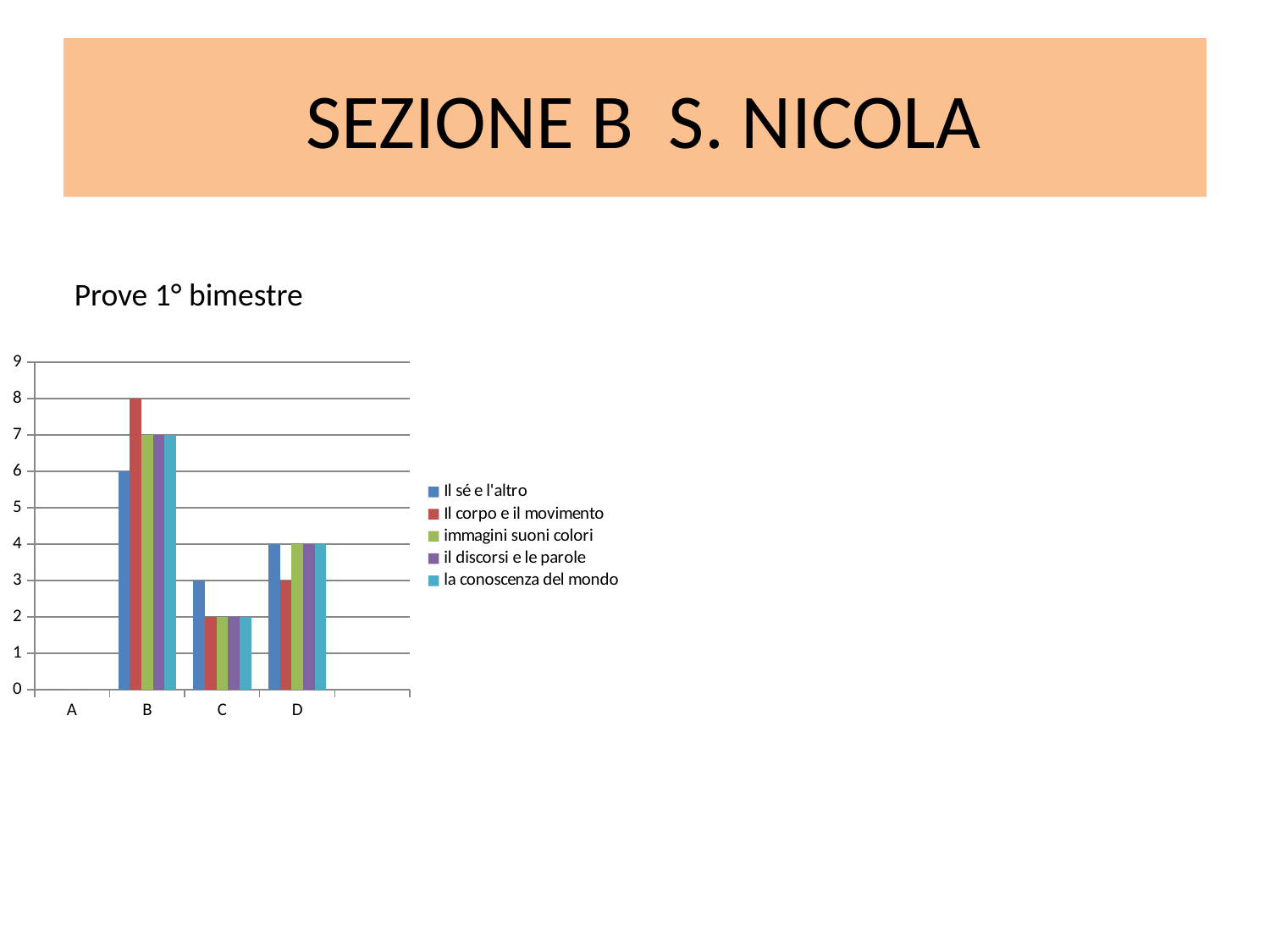
What is the value for 'la conoscenza del mondo' in category D? 4 How many series does the legend list? 5 Which category has the highest value for 'Il corpo e il movimento'? B What is the value for 'Il sé e l'altro' in category C? 3 What is the value for 'Il corpo e il movimento' in category B? 8 What is the difference between 'Il corpo e il movimento' and 'Il sé e l'altro' in category B? 2 How many categories are shown on the x axis? 4 What is the value for 'Il sé e l'altro' in category B? 6 Which is larger in category D: 'Il sé e l'altro' or 'Il corpo e il movimento'? Il sé e l'altro What kind of chart is shown on the slide? bar chart Which series has the highest value in category B? Il corpo e il movimento What is the text shown above the chart? Prove 1° bimestre